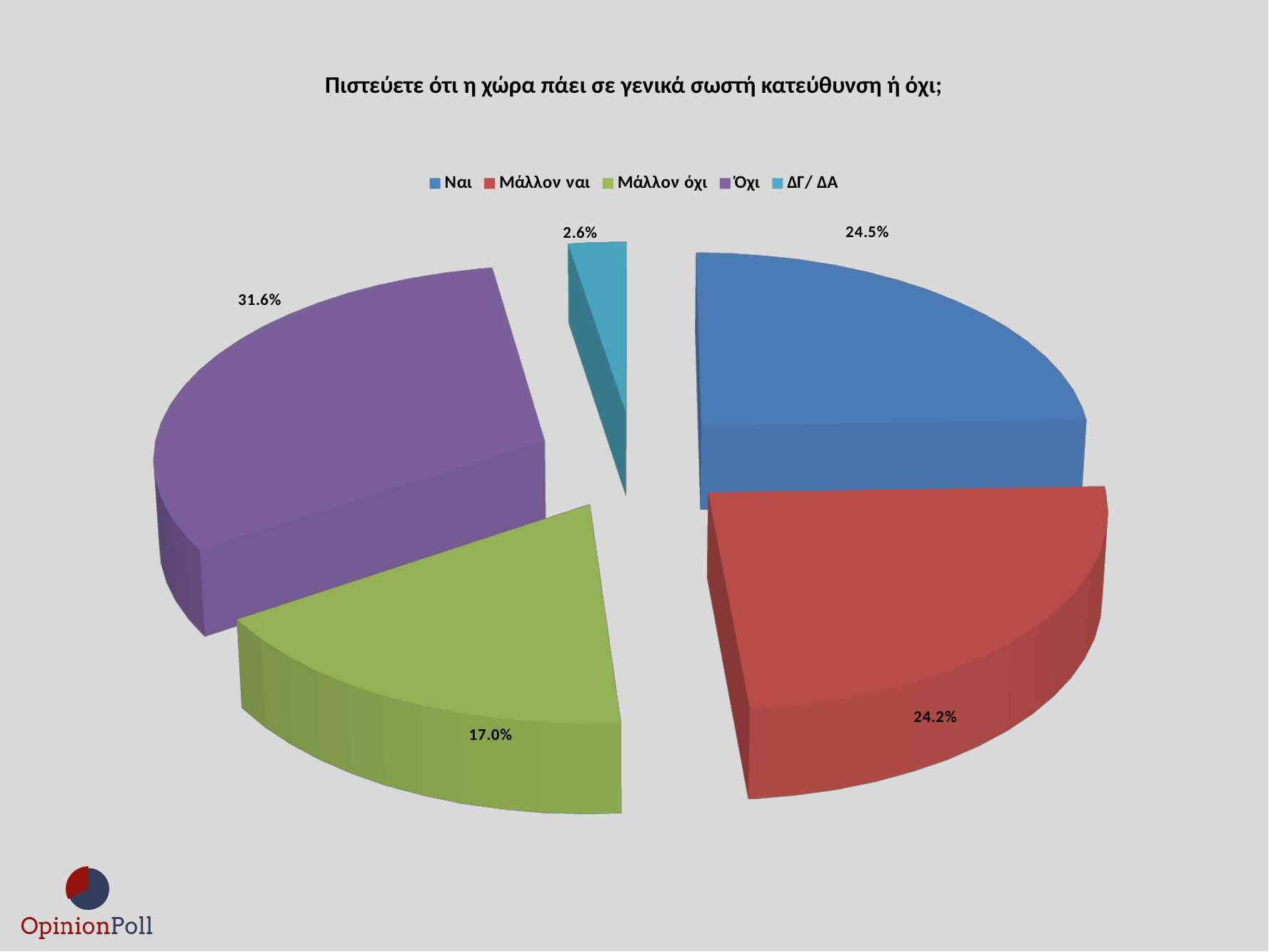
What percentage of respondents answered Ναι? 24.5% What percentage of respondents answered Μάλλον όχι? 17.0% How many slices does the pie chart have? 5 What colour is the slice for Μάλλον ναι? red What percentage of respondents answered Όχι? 31.6% What is the difference in percentage points between Ναι and Μάλλον ναι? 0.3 Which response has the smallest share of the pie? ΔΓ/ ΔΑ Which response has the largest share of the pie? Όχι Which is larger, the share for Όχι or the share for Μάλλον όχι? Όχι What percentage of respondents answered ΔΓ/ ΔΑ? 2.6% What is the difference in percentage points between Όχι and Ναι? 7.1 What kind of chart is shown on the slide? pie chart